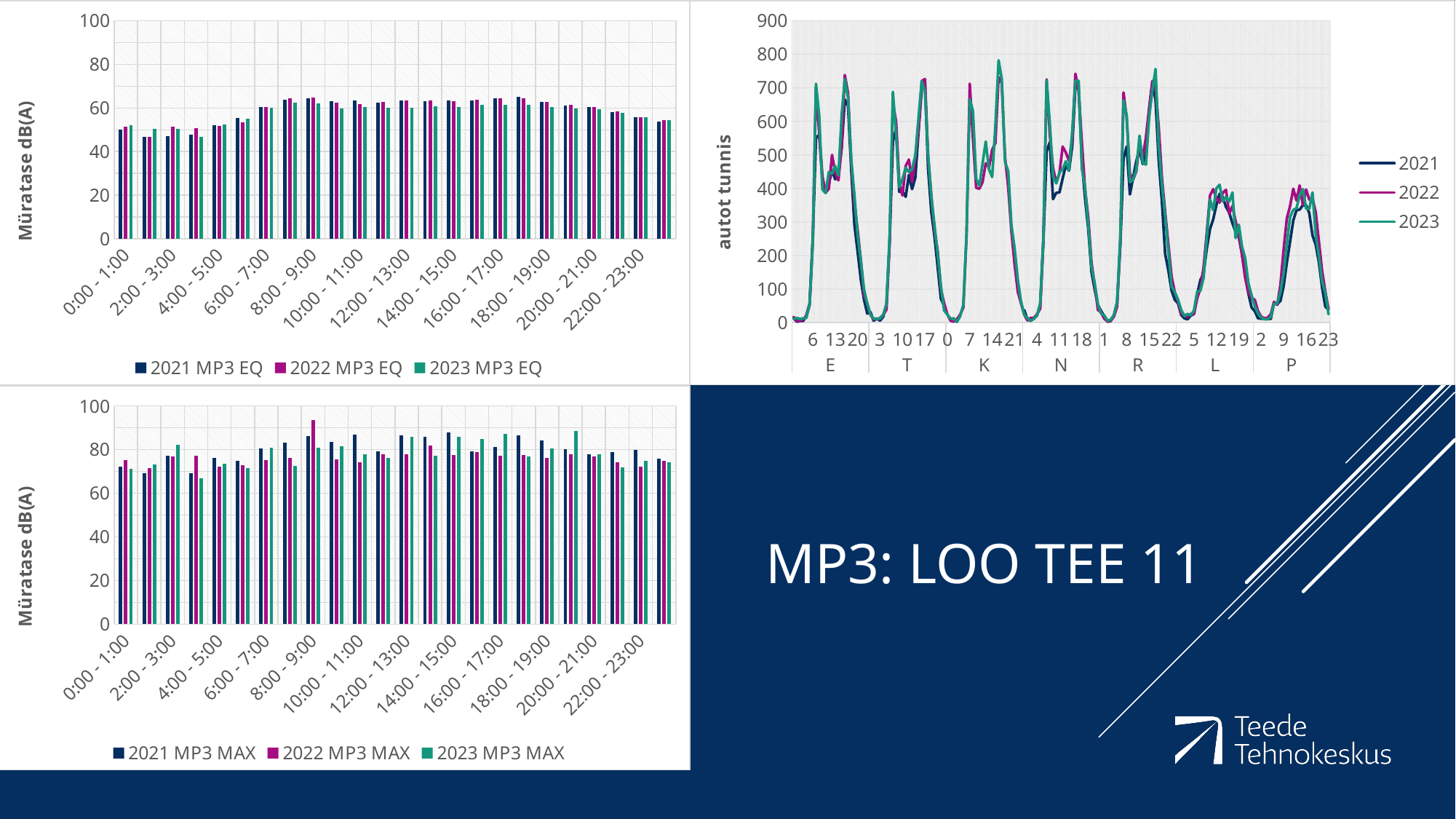
In the bottom-left chart (MP3 MAX), is the value for 2023 MP3 MAX at 4:00 - 5:00 greater or less than 70? greater What kind of chart is the top-right chart with the y-axis label 'autot tunnis'? line chart How many series does the legend of the top-right chart (autot tunnis) list? 3 In the top-left chart (MP3 EQ), do the 2021 MP3 EQ values rise or fall from 0:00 - 1:00 to 8:00 - 9:00? rise In the top-left chart (MP3 EQ), is the value for 2021 MP3 EQ at 0:00 - 1:00 greater or less than 60? less How many series does the legend of the top-left chart (MP3 EQ) list? 3 What kind of chart is the top-left chart with the legend '2021 MP3 EQ', '2022 MP3 EQ', '2023 MP3 EQ'? bar chart How many day groups (E, T, K, N, R, L, P) are shown on the x axis of the top-right chart (autot tunnis)? 7 In the bottom-left chart (MP3 MAX), which series has the single tallest bar? 2022 MP3 MAX In the top-left chart (MP3 EQ), is the value for 2021 MP3 EQ at 8:00 - 9:00 greater or less than 60? greater What is the y-axis label of the top-left chart (MP3 EQ)? Müratase dB(A)